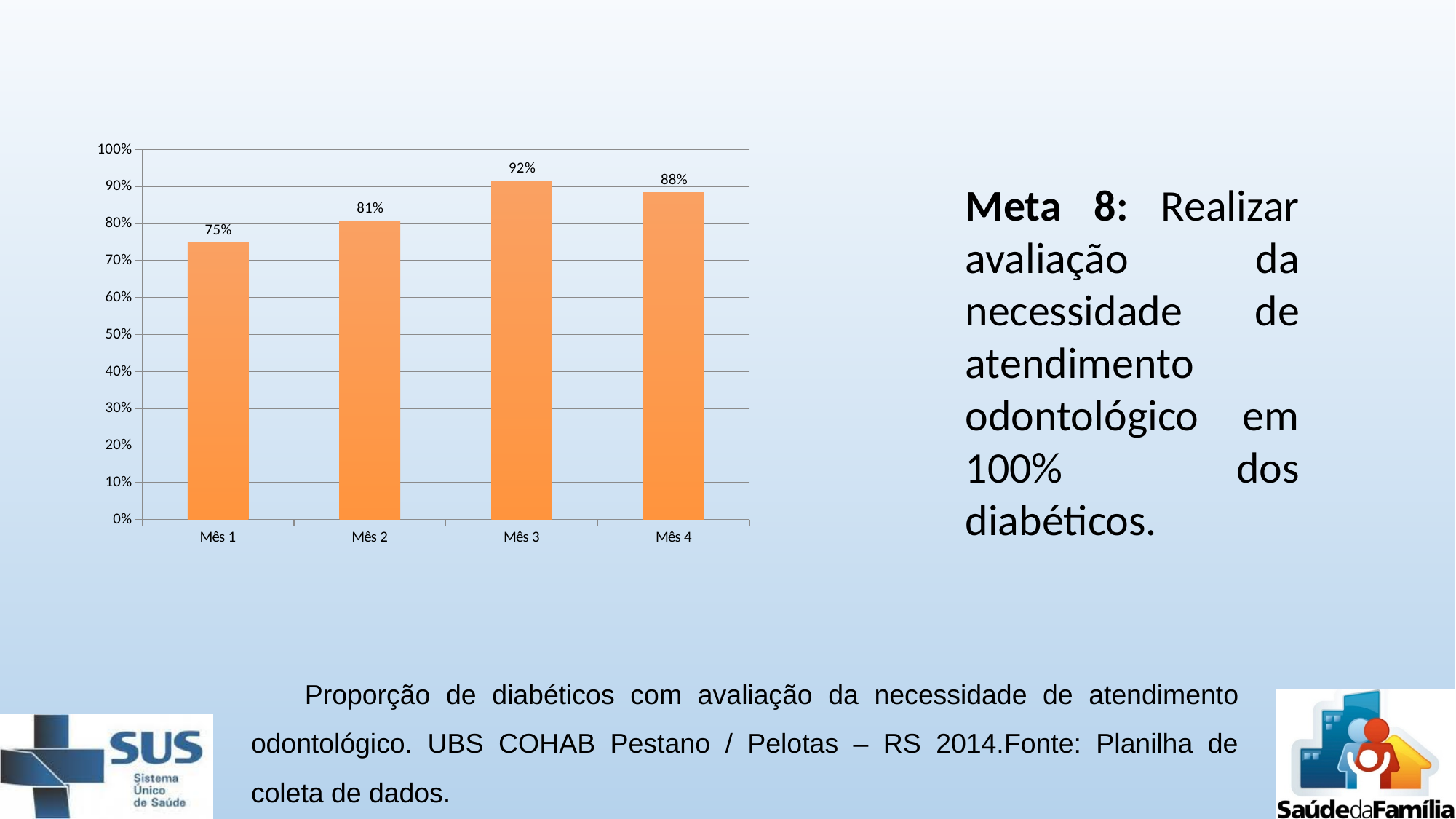
What is the value for Mês 1? 75% What is the difference between the values for Mês 3 and Mês 1? 17% Which month has the highest value? Mês 3 Is the value for Mês 2 greater or less than 90%? less Which is larger, the value for Mês 2 or the value for Mês 4? Mês 4 What is the value for Mês 3? 92% Which month has the lowest value? Mês 1 What colour are the bars in the chart? orange How many months are shown on the x axis? 4 What is the difference between the values for Mês 2 and Mês 1? 6% What is the value for Mês 4? 88% What kind of chart is shown on the slide? bar chart